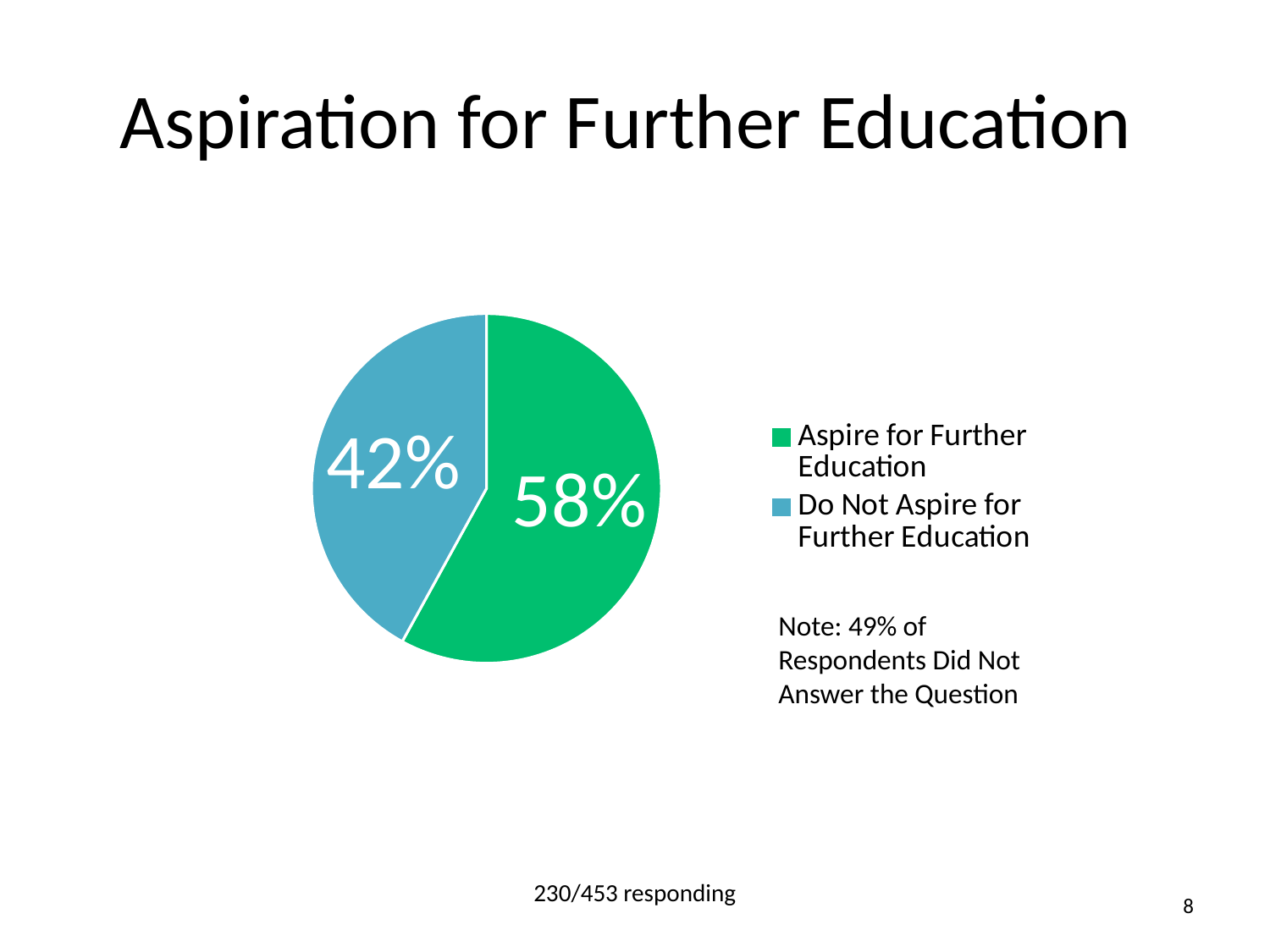
Which slice of the pie is the smallest? Do Not Aspire for Further Education What kind of chart is shown on the slide? pie chart What is the difference in percentage points between the "Aspire for Further Education" slice and the "Do Not Aspire for Further Education" slice? 16 percentage points Is the share for "Aspire for Further Education" greater or less than 50%? greater What share of the pie is labelled "Do Not Aspire for Further Education"? 42% Which slice of the pie is the largest? Aspire for Further Education How many slices does the pie chart have? 2 What share of the pie is labelled "Aspire for Further Education"? 58% What colour is the "Do Not Aspire for Further Education" slice? blue Which is larger: the "Aspire for Further Education" slice or the "Do Not Aspire for Further Education" slice? Aspire for Further Education How many entries does the legend list? 2 What is the title of the slide containing the pie chart? Aspiration for Further Education